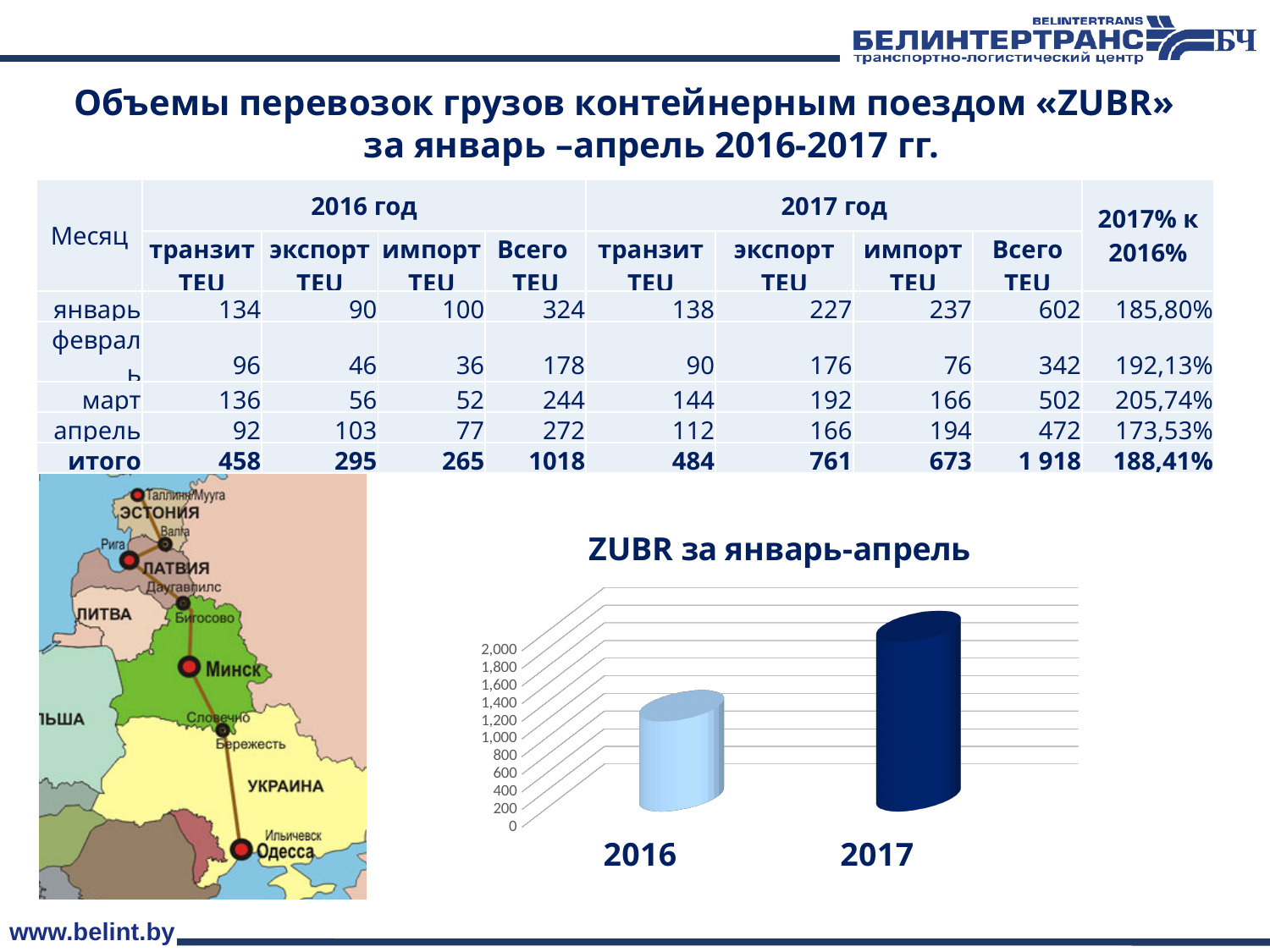
What is the highest tick value shown on the vertical axis of the "ZUBR за январь-апрель" chart? 2,000 What is the title of the chart on the slide? ZUBR за январь-апрель In the "ZUBR за январь-апрель" chart, is the bar for 2017 larger or smaller than the bar for 2016? larger Do the values in the "ZUBR за январь-апрель" chart rise or fall from 2016 to 2017? rise How many bars does the "ZUBR за январь-апрель" chart show? 2 Which year has the shorter bar in the "ZUBR за январь-апрель" chart? 2016 In the "ZUBR за январь-апрель" chart, is the value for 2016 greater or less than 1,600? less In the "ZUBR за январь-апрель" chart, is the value for 2017 greater or less than 1,200? greater In the "ZUBR за январь-апрель" chart, is the value for 2016 greater or less than 600? greater What kind of chart is shown under the title "ZUBR за январь-апрель"? bar chart Which year has the taller bar in the "ZUBR за январь-апрель" chart? 2017